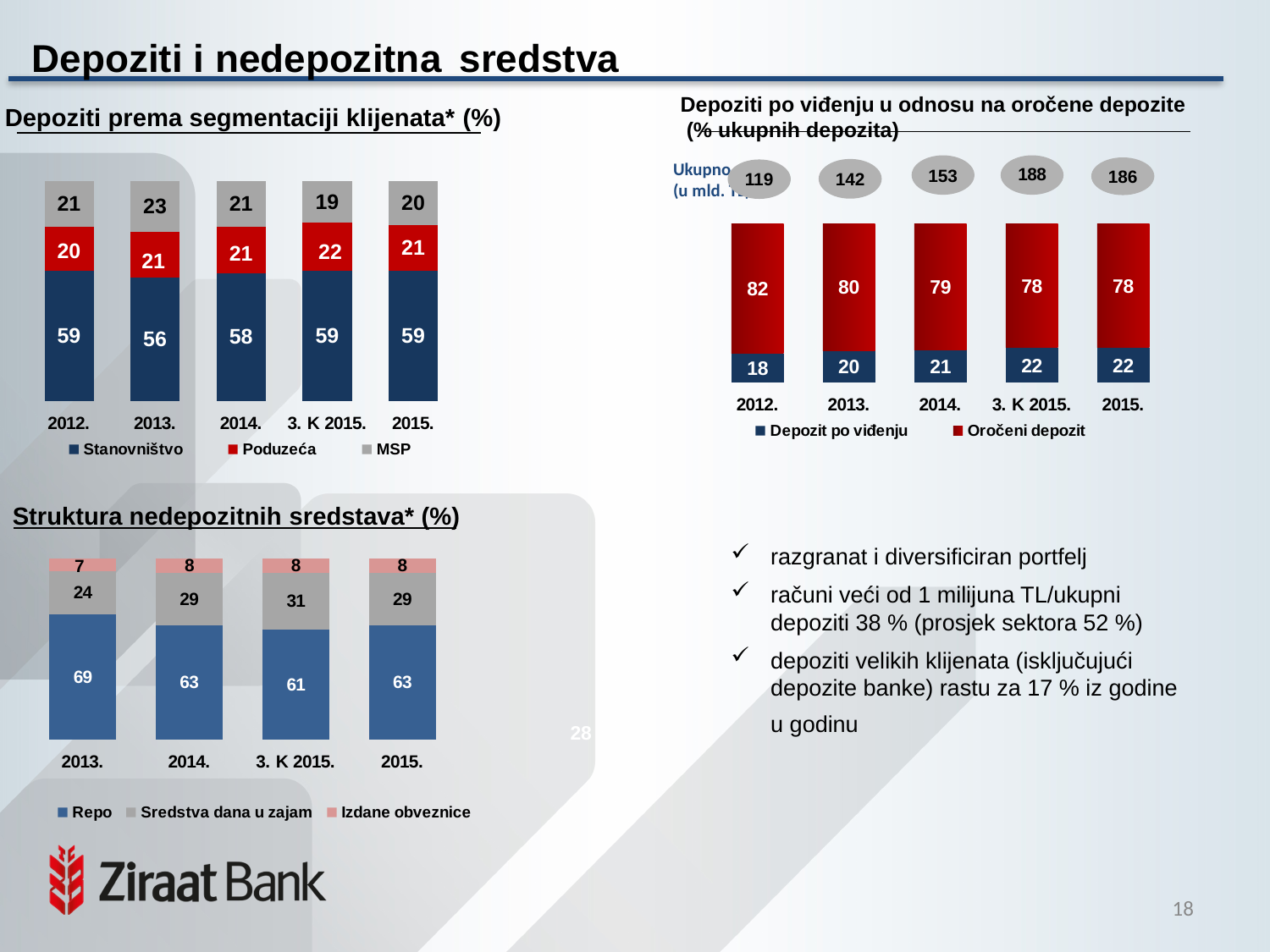
In the chart 'Depoziti po viđenju u odnosu na oročene depozite', what is the value for Oročeni depozit in 2014.? 79 In the chart 'Depoziti prema segmentaciji klijenata* (%)', what is the value for Stanovništvo in 2013.? 56 In the chart 'Depoziti prema segmentaciji klijenata* (%)', how many series does the legend list? 3 In the chart 'Depoziti prema segmentaciji klijenata* (%)', in which year is the Stanovništvo share lowest? 2013. In the chart 'Depoziti prema segmentaciji klijenata* (%)', what is the value for MSP in 3. K 2015.? 19 In the chart 'Depoziti po viđenju u odnosu na oročene depozite', what is the total (Ukupno) shown above the 3. K 2015. bar? 188 In the chart 'Struktura nedepozitnih sredstava* (%)', how many periods are shown on the x axis? 4 In the chart 'Depoziti po viđenju u odnosu na oročene depozite', does the Depozit po viđenju share rise or fall from 2012. to 2015.? Rise In the chart 'Depoziti po viđenju u odnosu na oročene depozite', which is larger in 2012.: Depozit po viđenju or Oročeni depozit? Oročeni depozit In the chart 'Struktura nedepozitnih sredstava* (%)', what kind of chart is it? Stacked bar chart In the chart 'Struktura nedepozitnih sredstava* (%)', what is the difference between the Sredstva dana u zajam values for 2014. and 2013.? 5 In the chart 'Struktura nedepozitnih sredstava* (%)', what is the value for Repo in 3. K 2015.? 61